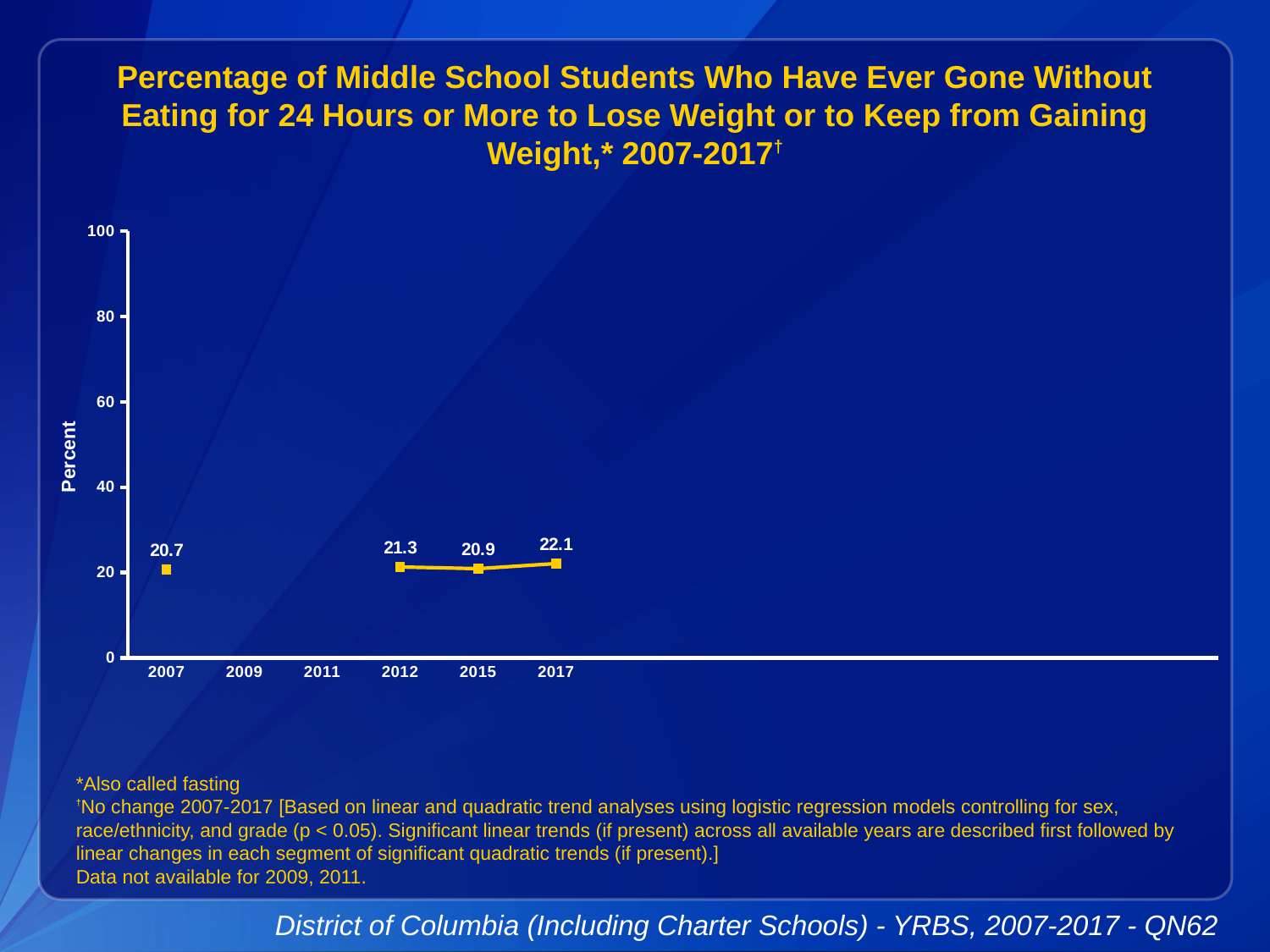
What is the value for 2007? 20.7 How many years have data points plotted on the chart? 4 Is the value for 2017 greater or less than 40? less Which year has the highest value? 2017 What is the value for 2017? 22.1 Which year has the lowest value? 2007 What is the label of the y axis? Percent What is the value for 2012? 21.3 Which is larger, the value for 2012 or the value for 2015? 2012 What is the value for 2015? 20.9 What is the difference between the values for 2012 and 2015? 0.4 What is the difference between the values for 2017 and 2007? 1.4